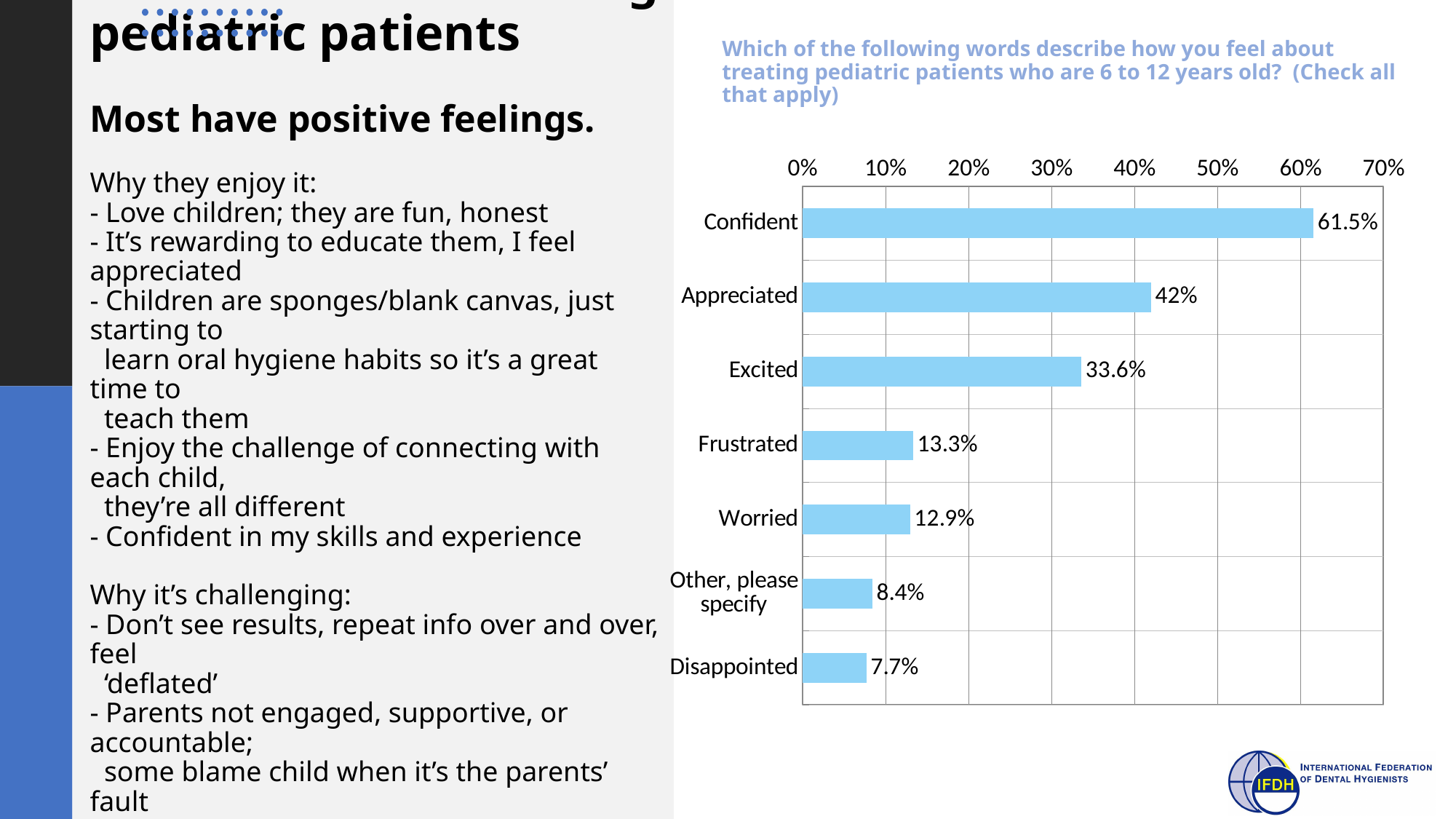
What is the value shown for "Excited"? 33.6% What percentage is shown for "Other, please specify"? 8.4% What kind of chart is shown on the slide? Bar chart How many categories (words) are shown in the chart? 7 What is the difference between the values for "Worried" and "Disappointed"? 5.2% Which word has the highest percentage in the chart? Confident Which has a larger value, "Frustrated" or "Worried"? Frustrated What percentage of respondents selected "Confident"? 61.5% What is the highest value shown on the chart's percentage axis? 70% Is the value for "Appreciated" greater or less than 40%? greater Which word has the lowest percentage in the chart? Disappointed What is the difference between the percentages for "Confident" and "Appreciated"? 19.5%